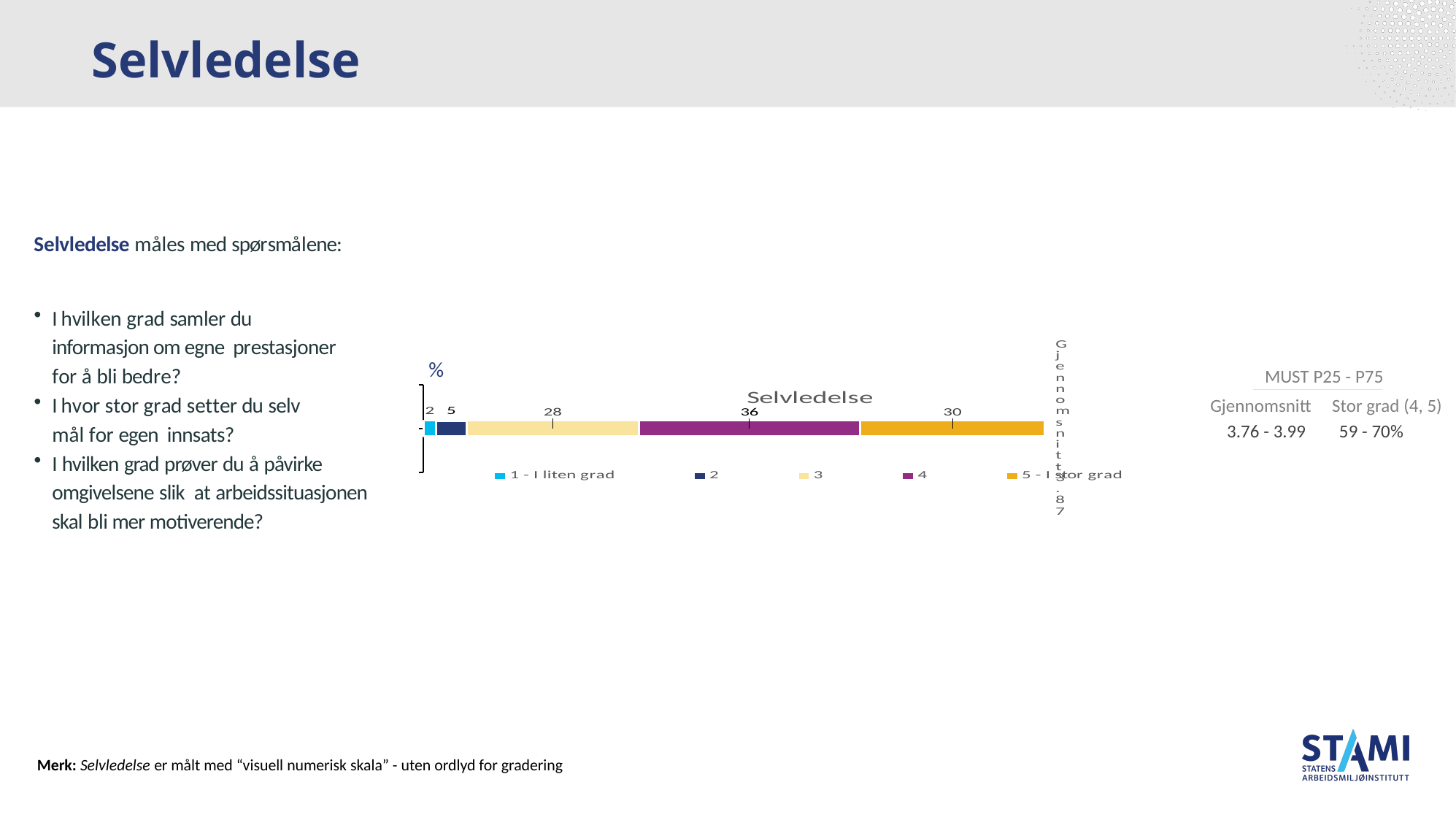
What is the value for "1 - I liten grad" in the Selvledelse chart? 2 How many series does the legend of the Selvledelse chart list? 5 What is the value for the series "4" in the Selvledelse chart? 36 What is the value for the series "3" in the Selvledelse chart? 28 What is the difference between the values for series "4" and series "3" in the Selvledelse chart? 8 Which series has the lowest value in the Selvledelse chart? 1 - I liten grad What is the title of the chart on the slide? Selvledelse Which series has the highest value in the Selvledelse chart? 4 Which is larger in the Selvledelse chart, the value for series "2" or for "5 - I stor grad"? 5 - I stor grad What is the total of the stacked bar in the Selvledelse chart? 101 What is the value for "5 - I stor grad" in the Selvledelse chart? 30 What kind of chart is shown on the slide? bar chart